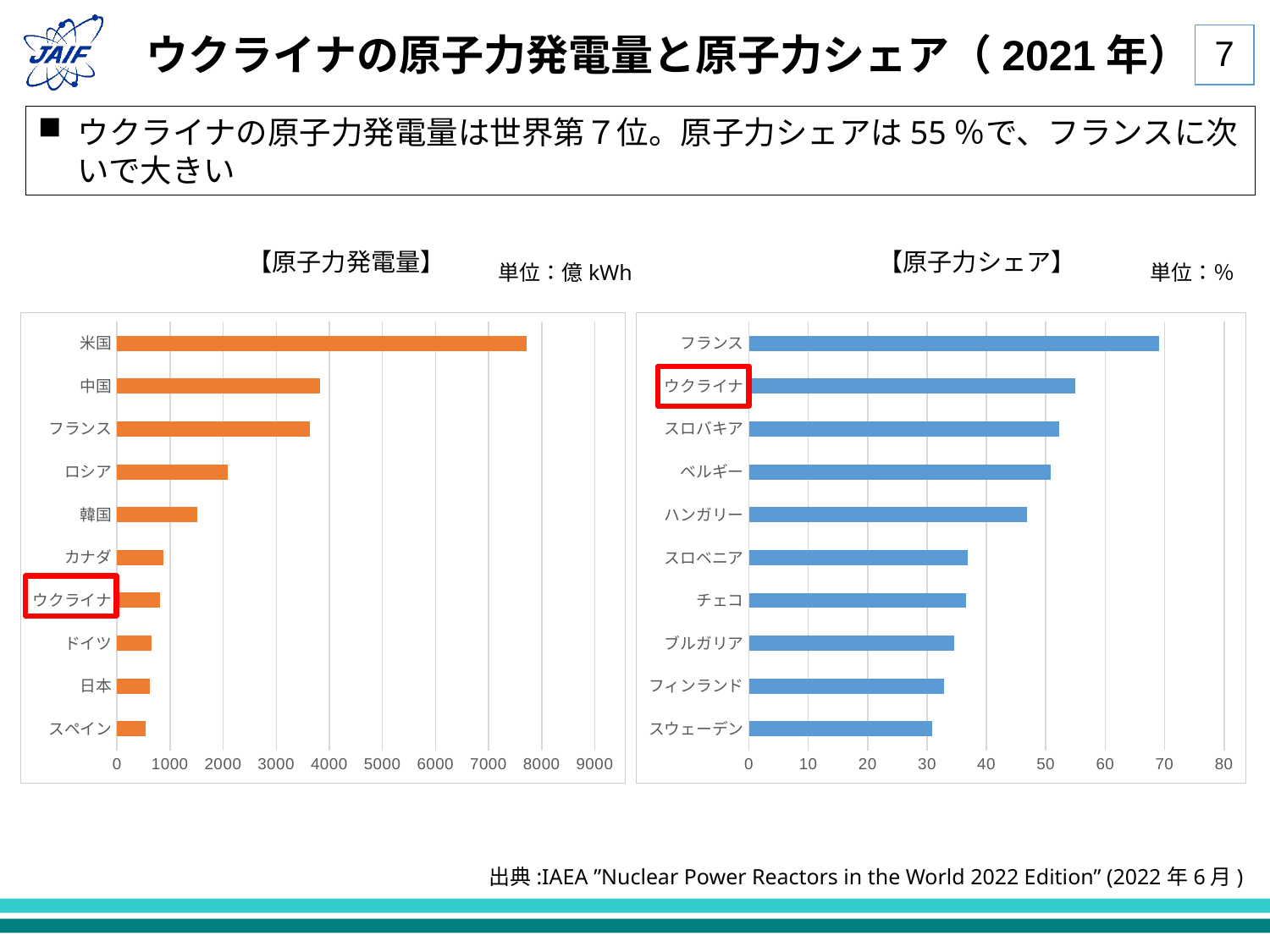
In the left chart 【原子力発電量】, how many countries are shown? 10 In the left chart 【原子力発電量】, is the value for 米国 greater or less than 7000? greater What kind of chart is the left chart titled 【原子力発電量】? bar chart In the left chart 【原子力発電量】, which country has the lowest value? スペイン In the right chart 【原子力シェア】, which country has the highest value? フランス In the right chart 【原子力シェア】, is the value for ウクライナ greater or less than 50? greater In the left chart 【原子力発電量】, is the value for 中国 greater or less than 3000? greater What unit is stated for the left chart 【原子力発電量】? 億 kWh In the right chart 【原子力シェア】, which is larger, the value for ハンガリー or the value for スロベニア? ハンガリー In the left chart 【原子力発電量】, which country has the highest value? 米国 In the left chart 【原子力発電量】, which is larger, the value for ロシア or the value for 韓国? ロシア In the right chart 【原子力シェア】, which country has the lowest value? スウェーデン